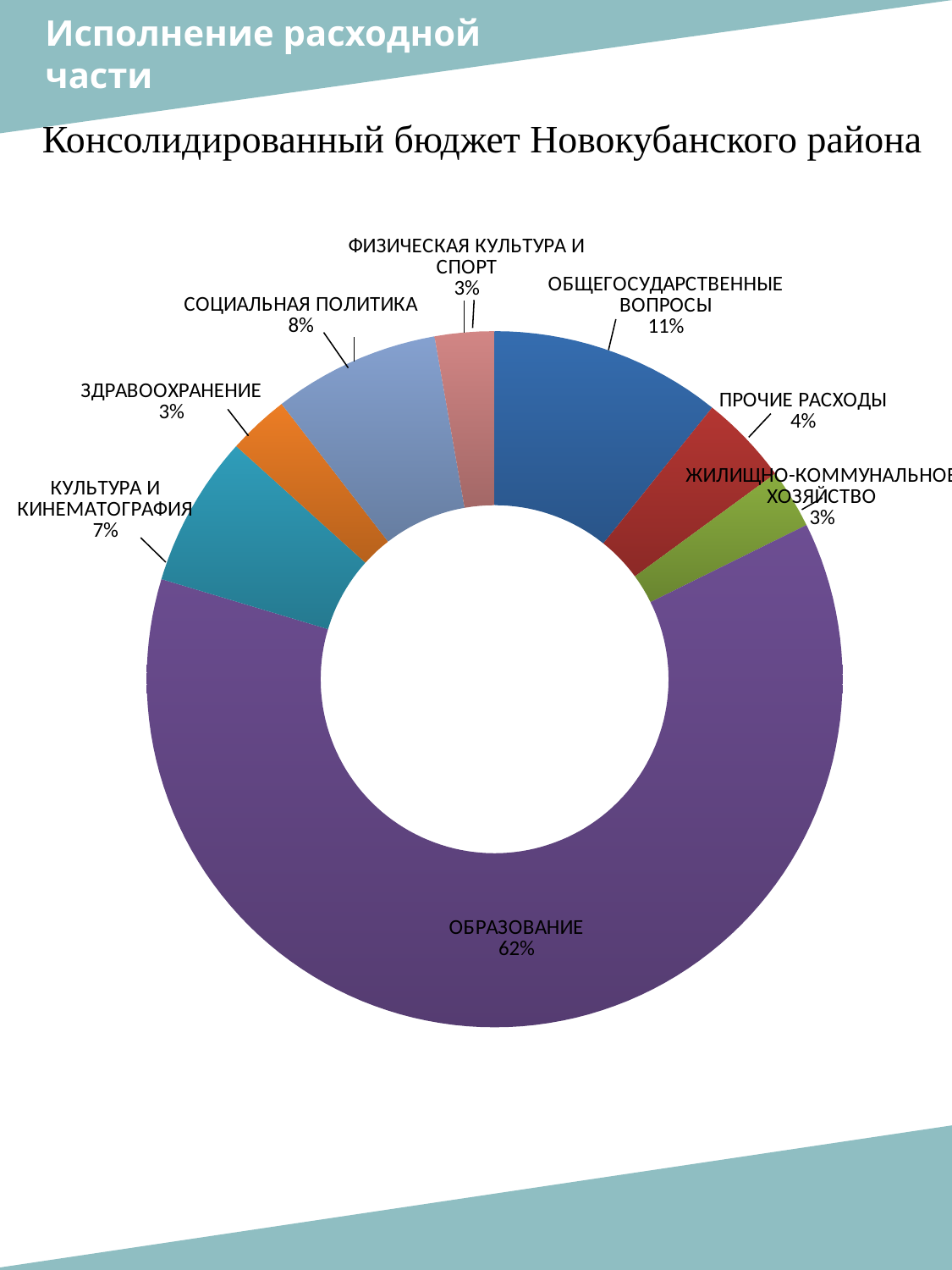
What kind of chart is shown on the slide? Pie (doughnut) chart How many categories are shown in the chart? 8 Which category has the largest share of the chart? ОБРАЗОВАНИЕ What is the difference in percentage points between ОБРАЗОВАНИЕ and ОБЩЕГОСУДАРСТВЕННЫЕ ВОПРОСЫ? 51 percentage points Which is larger, ОБЩЕГОСУДАРСТВЕННЫЕ ВОПРОСЫ or СОЦИАЛЬНАЯ ПОЛИТИКА? ОБЩЕГОСУДАРСТВЕННЫЕ ВОПРОСЫ What is the value shown for ОБЩЕГОСУДАРСТВЕННЫЕ ВОПРОСЫ? 11% What is the value shown for ЗДРАВООХРАНЕНИЕ? 3% What is the value shown for КУЛЬТУРА И КИНЕМАТОГРАФИЯ? 7% What share of the chart does ОБРАЗОВАНИЕ account for? 62% What is the value shown for СОЦИАЛЬНАЯ ПОЛИТИКА? 8% What is the title of the chart on the slide? Консолидированный бюджет Новокубанского района What is the value shown for ПРОЧИЕ РАСХОДЫ? 4%